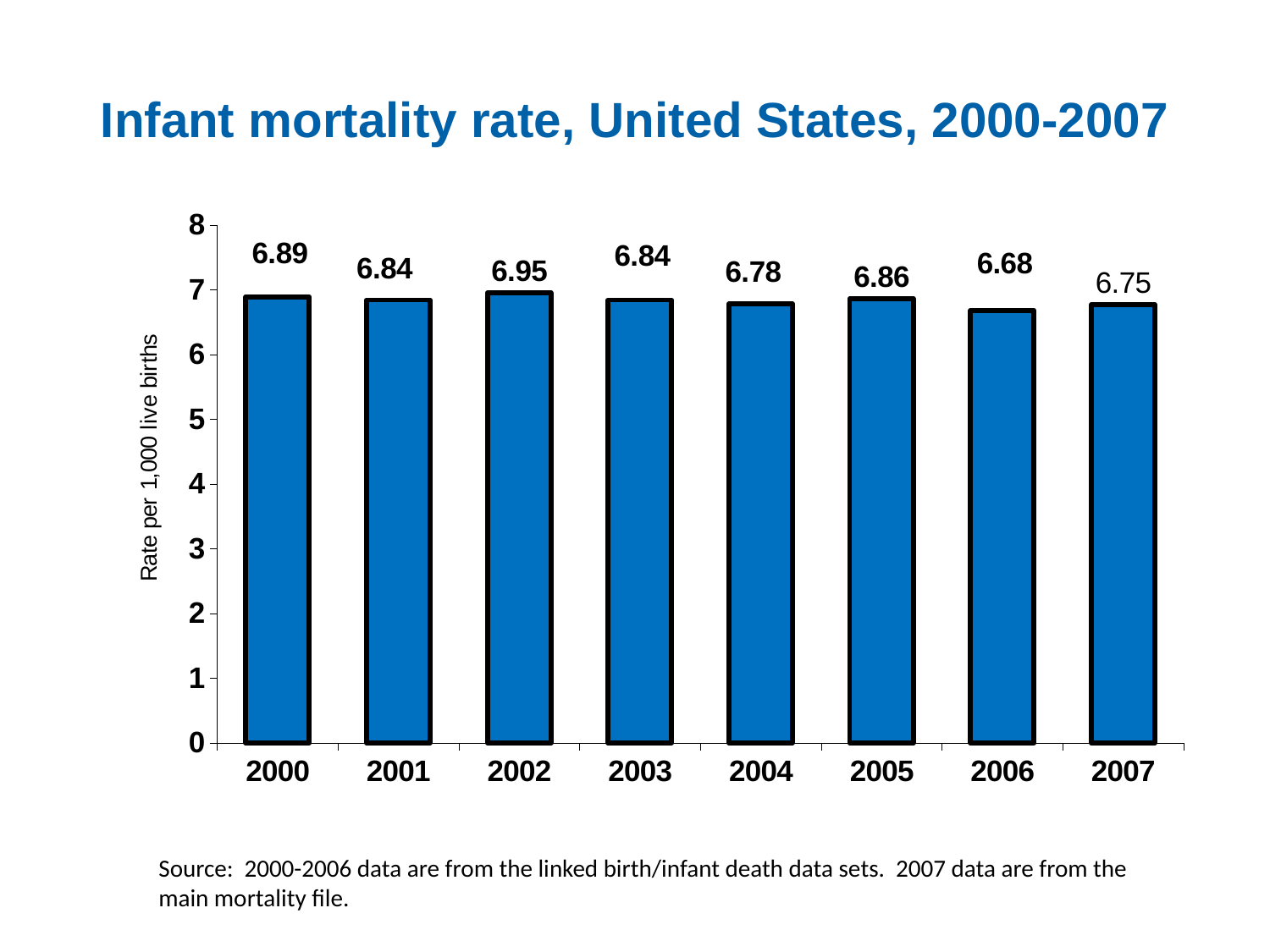
What is the infant mortality rate for 2007? 6.75 Which year has a higher infant mortality rate, 2000 or 2007? 2000 How many years are shown on the chart? 8 What is the label of the vertical axis? Rate per 1,000 live births Which year has the lowest infant mortality rate? 2006 What kind of chart is shown on the slide? bar chart What is the difference between the infant mortality rate in 2002 and in 2006? 0.27 What is the infant mortality rate for 2004? 6.78 Which year has the highest infant mortality rate? 2002 What is the title of the chart? Infant mortality rate, United States, 2000-2007 What is the infant mortality rate for 2000? 6.89 Is the infant mortality rate for 2006 greater or less than 7? less